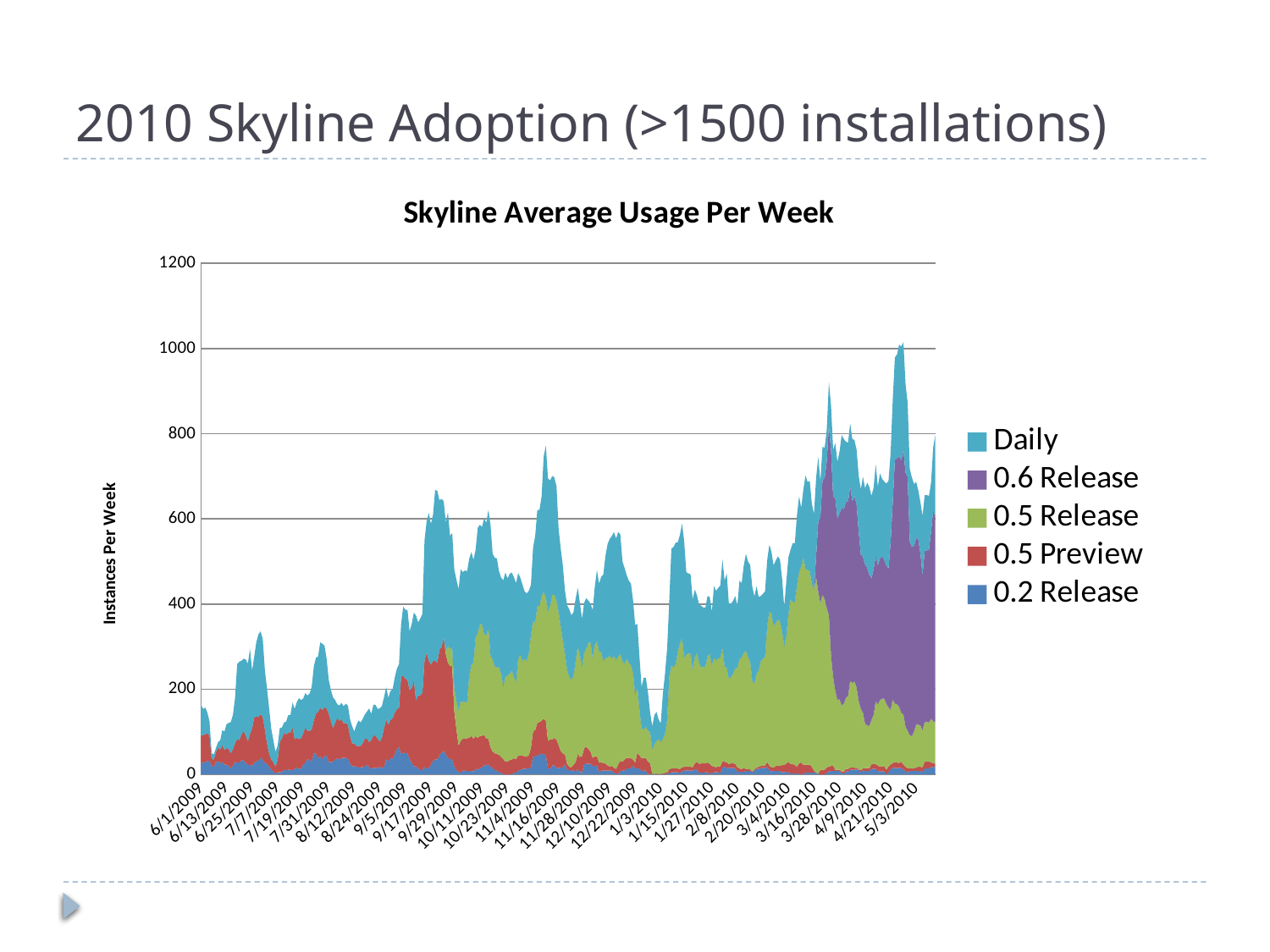
What is the label on the vertical axis of the chart? Instances Per Week Is the total value around 11/4/2009 greater or less than 400? greater What is the title of the chart? Skyline Average Usage Per Week What is the highest value shown on the vertical axis? 1200 Which date has the larger total value, 4/21/2010 or 6/1/2009? 4/21/2010 Is the total value at 6/1/2009 greater or less than 400? less Is the total value around 3/16/2010 greater or less than 400? greater How many series does the chart's legend list? 5 Overall, do the total instances per week rise or fall from 6/1/2009 to 5/3/2010? Rise What kind of chart is shown on the slide? Stacked area chart